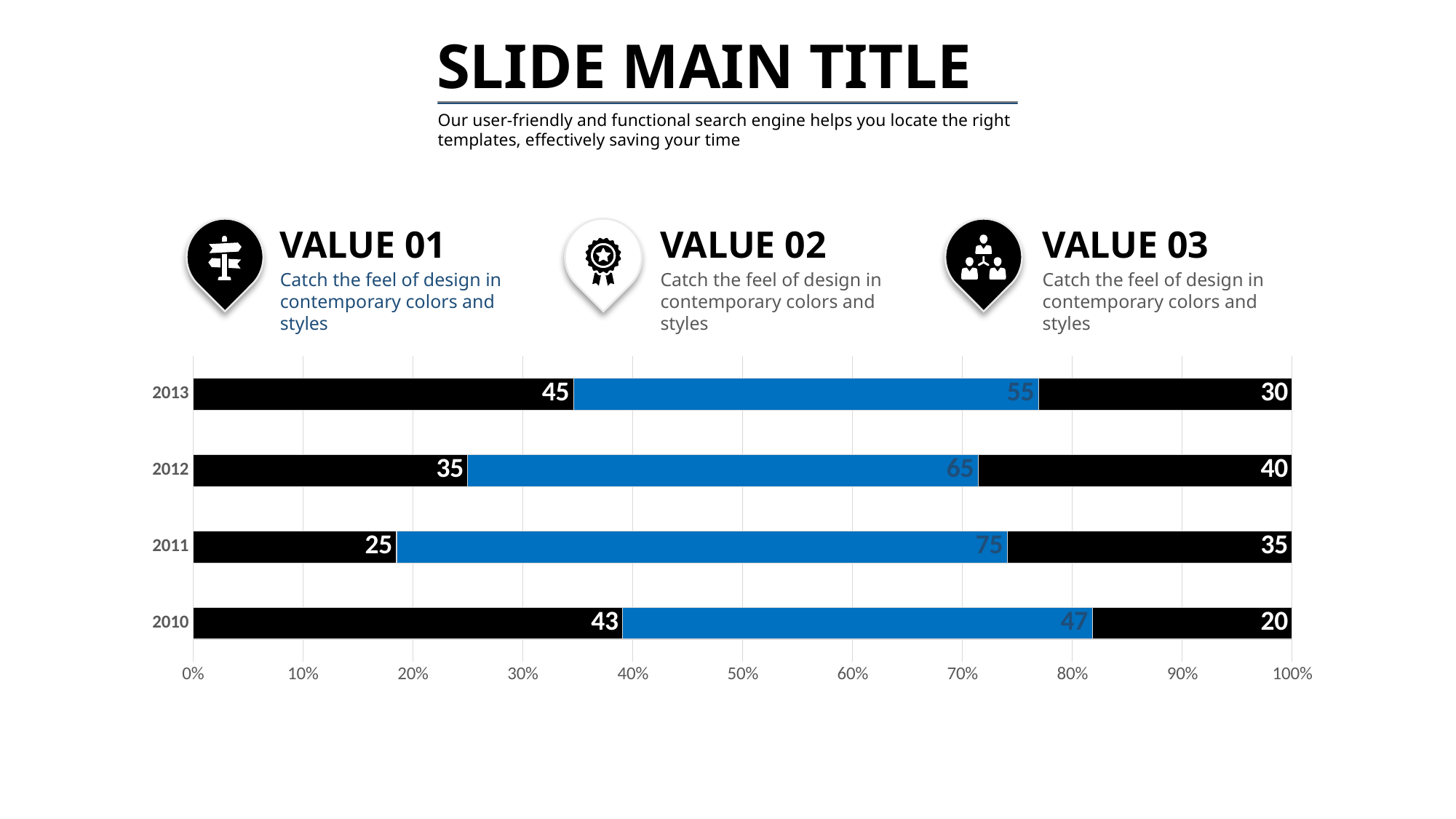
Which year has the lowest value in the leftmost black segment? 2011 What is the value of the rightmost black segment for 2010? 20 What is the difference between the middle blue segment values for 2011 and 2010? 28 Which is larger: the rightmost black segment for 2012 or for 2013? 2012 What is the label on the horizontal axis at its far right end? 100% How many categories (years) are shown on the chart's vertical axis? 4 Which year has the highest value in the middle blue segment? 2011 What is the value of the middle blue segment for 2011? 75 What kind of chart is shown on the slide? Stacked bar chart What is the value of the middle blue segment for 2012? 65 What is the total of the three segment values for 2013? 130 What is the value of the leftmost black segment for 2013? 45